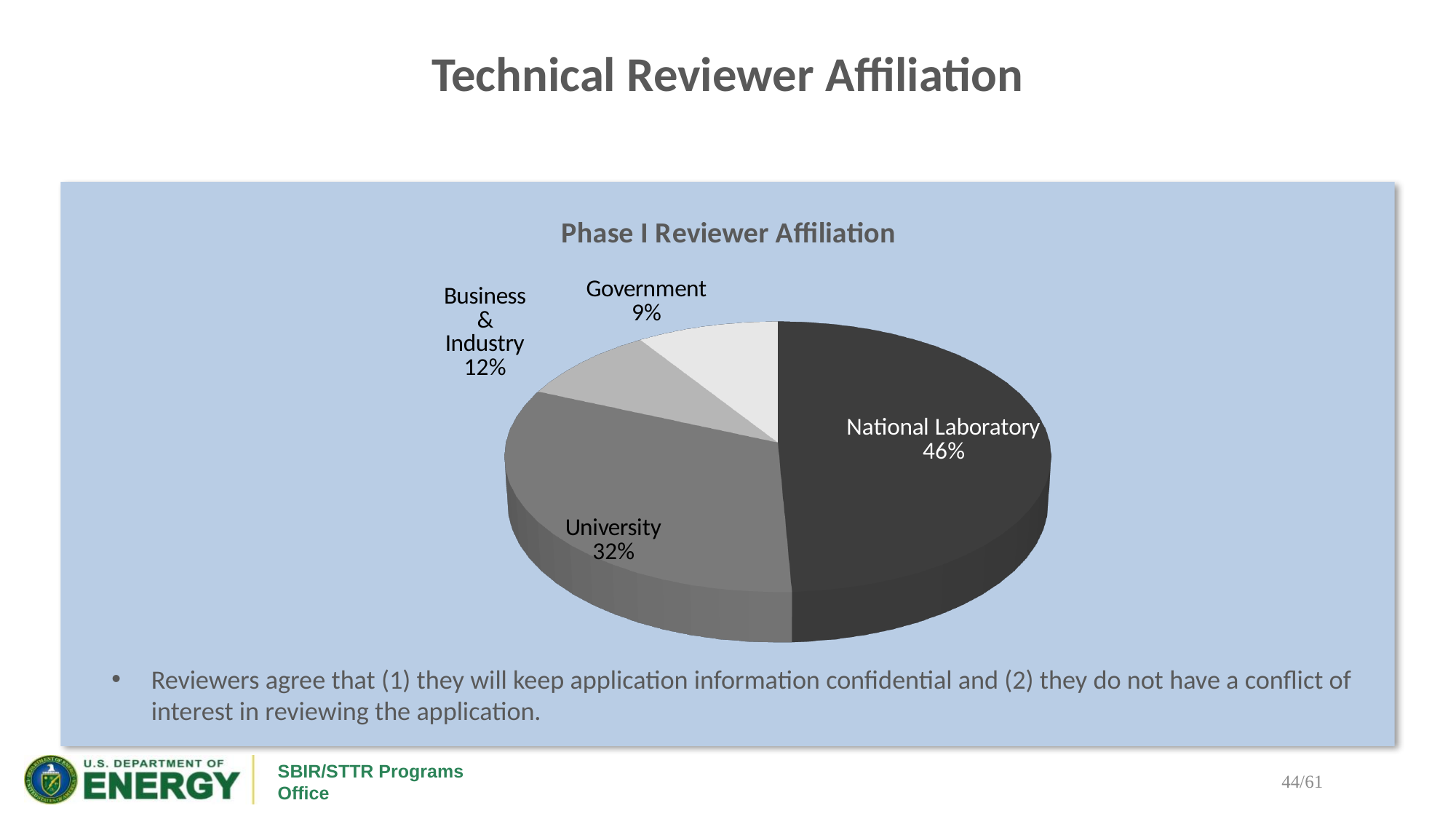
What share of Phase I reviewers are affiliated with a National Laboratory? 46% What is the combined share of University and Business & Industry reviewers? 44% Which affiliation has the largest share of Phase I reviewers? National Laboratory What is the title of the chart? Phase I Reviewer Affiliation What type of chart is shown on the slide? Pie chart How many percentage points larger is the National Laboratory share than the University share? 14 What percentage of Phase I reviewers are from Government? 9% What percentage of Phase I reviewers are from Business & Industry? 12% How many affiliation categories does the pie chart show? 4 What percentage of Phase I reviewers are from a University? 32% Which is larger, the Business & Industry share or the Government share? Business & Industry Which affiliation has the smallest share of Phase I reviewers? Government